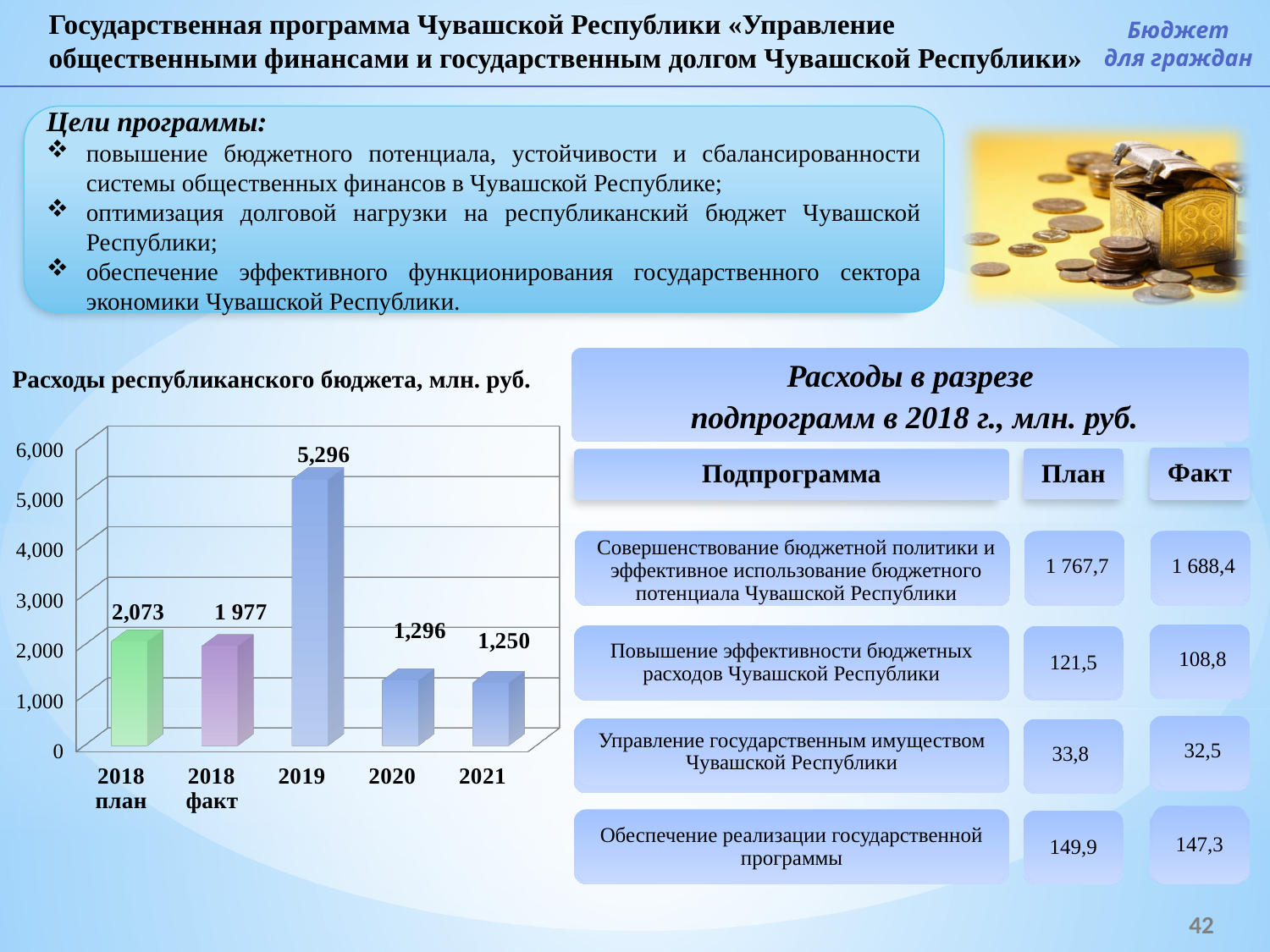
What is the value for 2019 in the chart 'Расходы республиканского бюджета, млн. руб.'? 5,296 How many bars are shown in the chart? 5 What is the value for '2018 план' in the chart? 2,073 What type of chart is shown on the slide? bar chart Which is larger, the value for '2018 план' or the value for '2018 факт'? 2018 план Which category has the highest value in the chart? 2019 Is the value for 2020 greater or less than 2,000? less What is the value for 2021 in the chart? 1,250 What is the difference between the 2020 value and the 2021 value? 46 What is the value for '2018 факт' in the chart? 1 977 Which category has the lowest value in the chart? 2021 What is the difference between the 2019 value and the '2018 план' value? 3,223